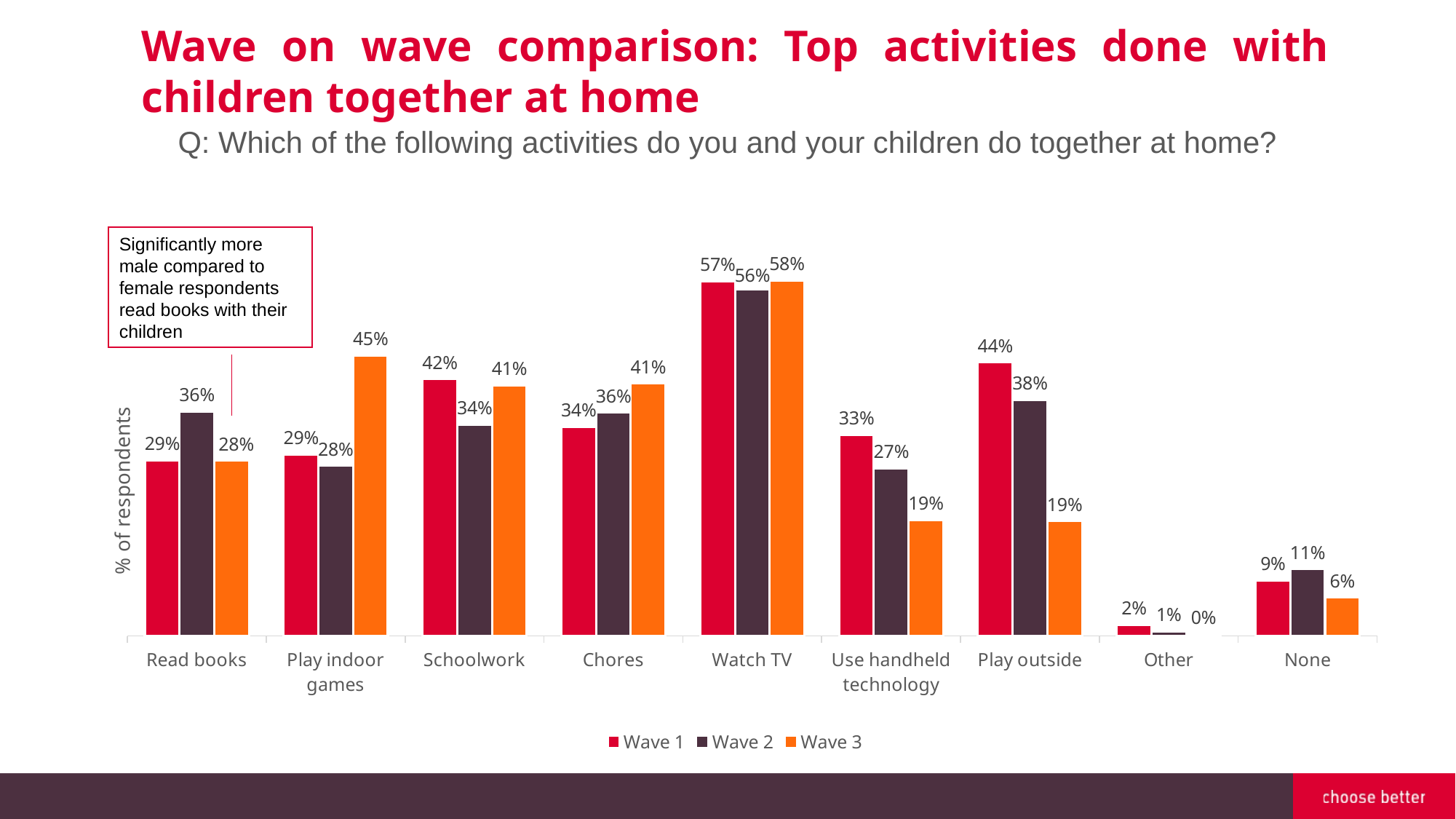
What kind of chart is shown on the slide? Bar chart Which activity has the highest Wave 3 value? Watch TV What is the Wave 2 value for Use handheld technology? 27% Which activity has the lowest Wave 1 value? Other What is the Wave 3 value for Play indoor games? 45% What is the label on the vertical axis? % of respondents What is the Wave 1 value for Play outside? 44% How many series does the legend list? 3 What is the Wave 3 value for Other? 0% Which is larger for Schoolwork: the Wave 1 value or the Wave 2 value? Wave 1 How many activity categories are shown on the x axis? 9 What is the difference between the Wave 1 and Wave 3 values for Play outside? 25%